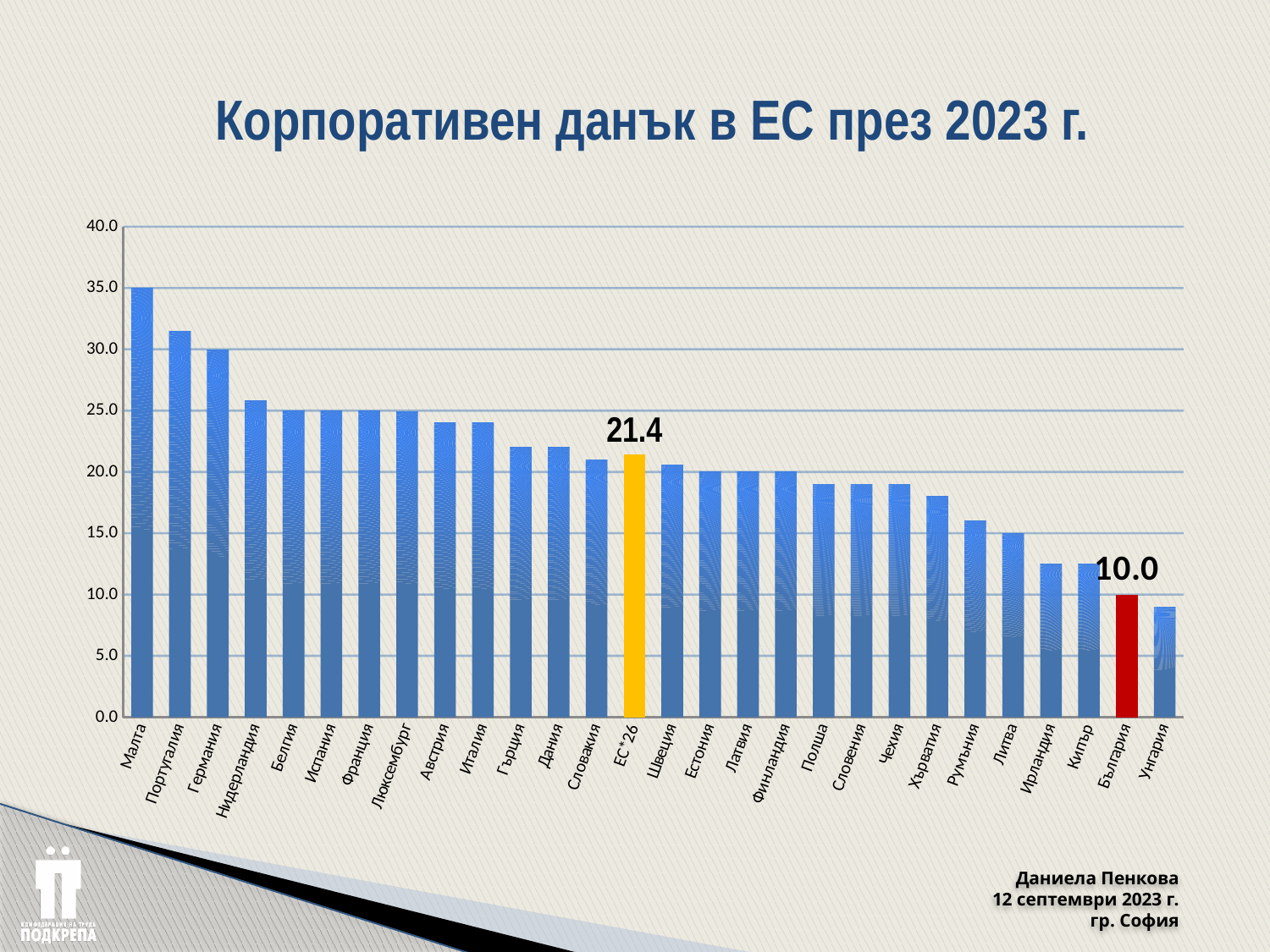
Is the value for Ирландия greater or less than 15.0? less What is the value shown for ЕС*26? 21.4 What is the difference between the value for ЕС*26 and the value for България? 11.4 Which country has the highest corporate tax rate in the chart? Малта What kind of chart is shown on the slide? Bar chart Which is larger, the value for ЕС*26 or the value for България? ЕС*26 Do the values generally rise or fall from left to right along the x axis? Fall Is the value for Португалия greater or less than 30.0? greater What is the value shown for България? 10.0 Which country has the lowest corporate tax rate in the chart? Унгария Is the value for Нидерландия greater or less than 25.0? greater How many bars (categories) are shown in the chart? 28